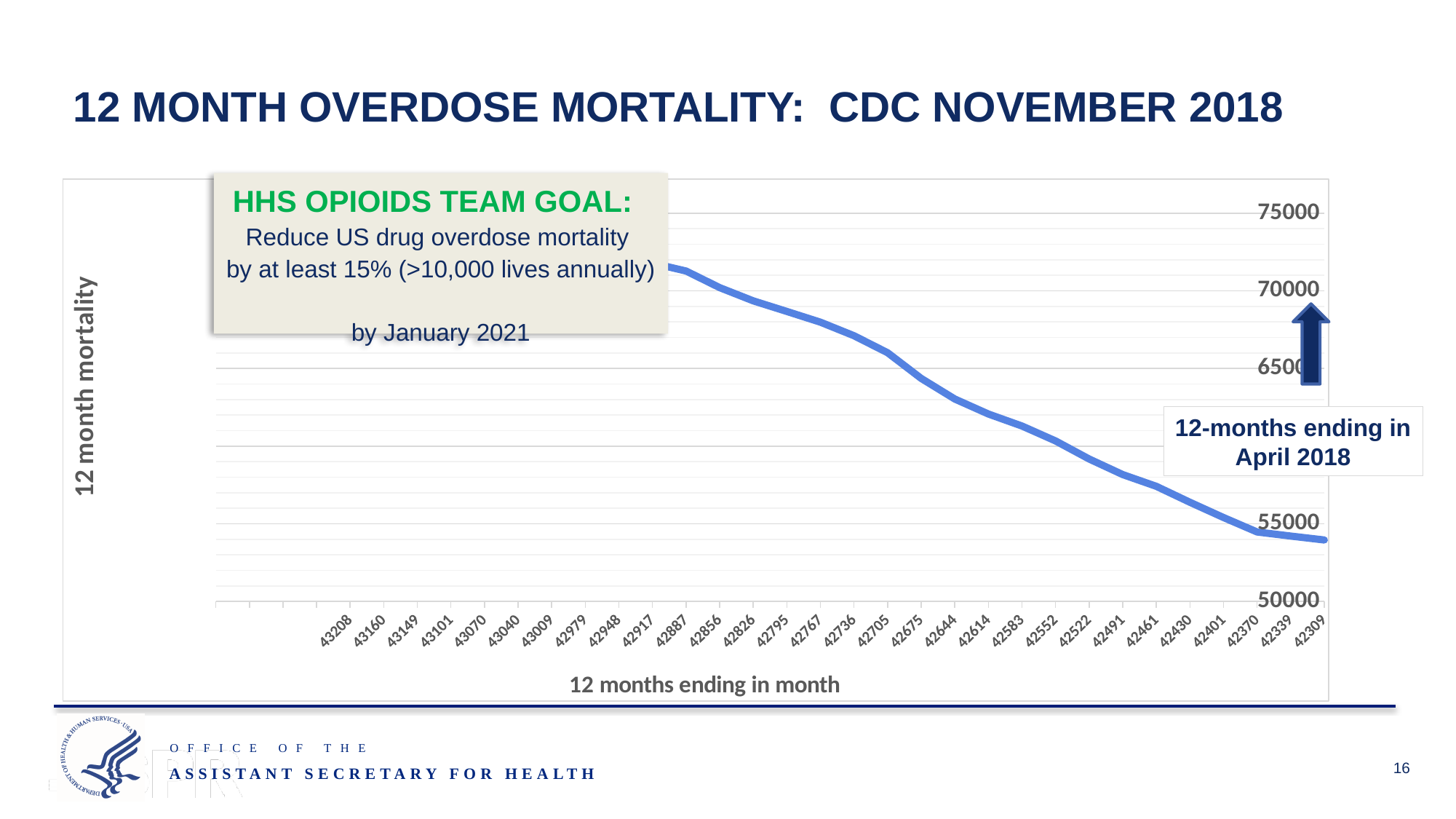
What kind of chart is shown on the slide? line chart What is the title of the chart's y axis? 12 month mortality Do the plotted values rise or fall moving from left to right along the x axis? fall Is the value at x-axis label 42491 greater or less than 60000? less Is the value at x-axis label 42614 greater or less than 65000? less Is the value at x-axis label 42370 greater or less than 55000? less What is the title of the chart's x axis? 12 months ending in month At which x-axis label does the line reach its lowest value? 42309 Which has the larger value, the point at 42887 or the point at 42309? 42887